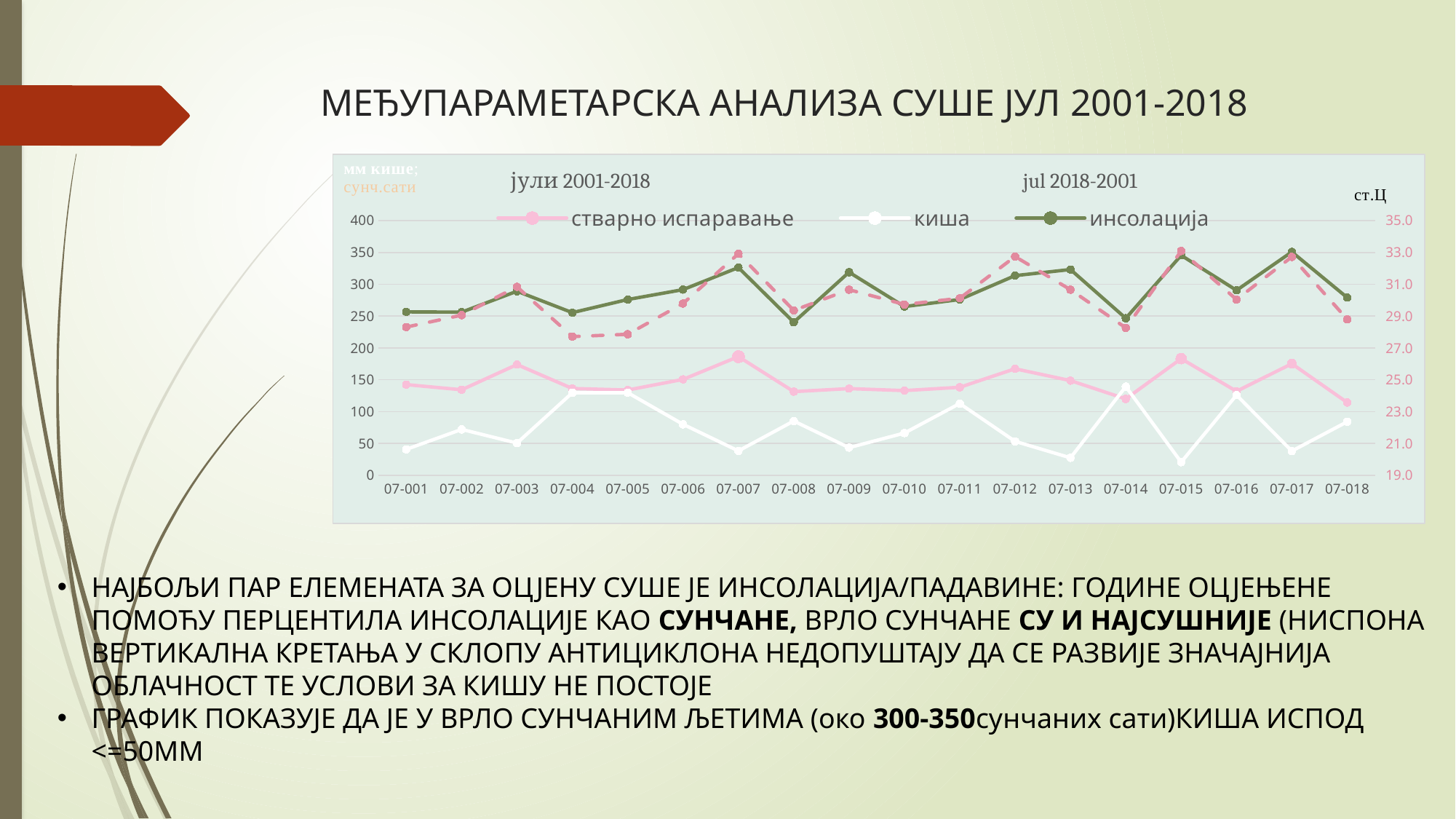
Is the value of инсолација for 07-008 greater or less than 250? less How many categories are shown along the x axis of the chart? 18 How many series does the chart legend list? 3 Is the value of киша for 07-004 greater or less than 100? greater Which has the larger инсолација value, 07-007 or 07-008? 07-007 Is the value of инсолација for 07-007 greater or less than 300? greater Does the инсолација line rise or fall from 07-007 to 07-008? fall Which has the larger киша value, 07-004 or 07-015? 07-004 What kind of chart is shown on the slide? line chart What is the label of the secondary (right-hand) axis of the chart? ст.Ц